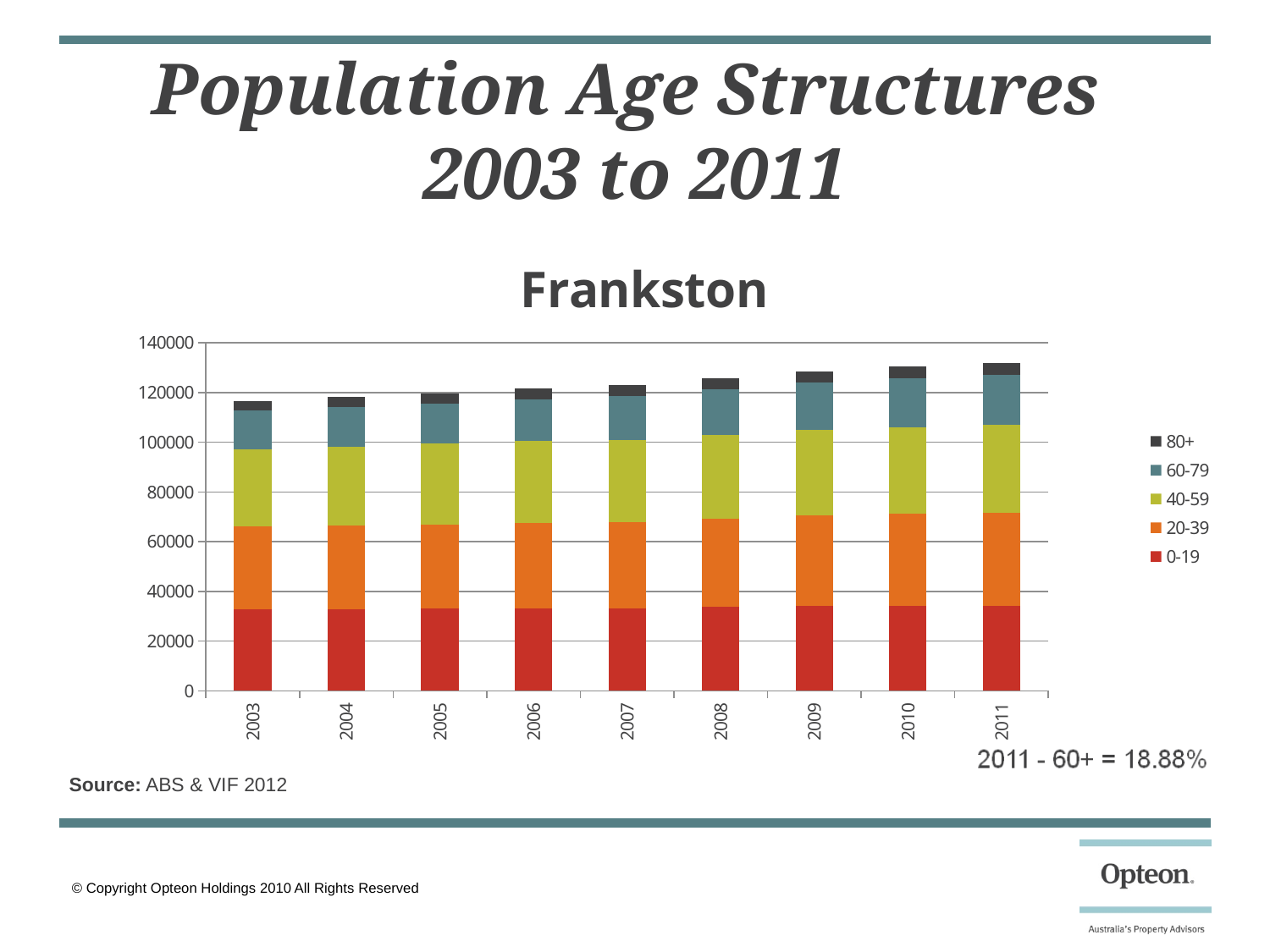
Which year has the lowest total population? 2003 Which age group is listed at the bottom of the legend? 0-19 What is the title of the chart? Frankston What kind of chart is shown on the slide? Stacked bar chart Which year has the highest total population? 2011 Is the value for the 0-19 group in 2003 greater or less than 40000? less Is the total population for 2011 greater or less than 120000? greater How many series does the legend list? 5 Does the total population rise or fall from 2003 to 2011? Rise Is the total population for 2003 greater or less than 100000? greater How many years are shown on the x axis? 9 Which is larger, the total population in 2011 or in 2003? 2011